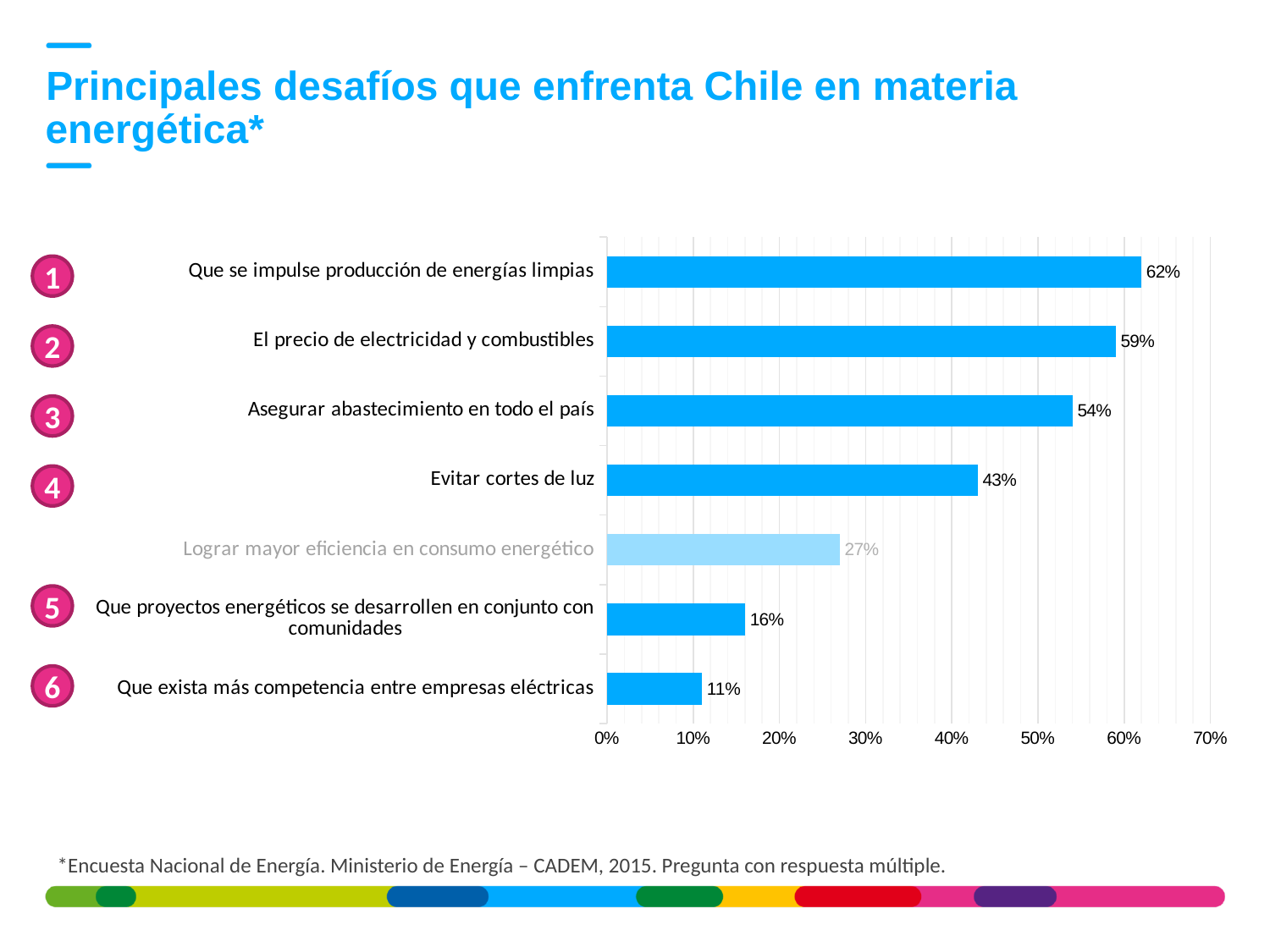
Which category has the highest value? Que se impulse producción de energías limpias What is the difference between "El precio de electricidad y combustibles" and "Asegurar abastecimiento en todo el país"? 5% How many categories are shown in the chart? 7 What is the value for "Que se impulse producción de energías limpias"? 62% Which category has the lowest value? Que exista más competencia entre empresas eléctricas Is the value for "Que proyectos energéticos se desarrollen en conjunto con comunidades" greater or less than 20%? less What kind of chart is shown on the slide? bar chart What is the title of the slide? Principales desafíos que enfrenta Chile en materia energética* Which is larger: "Evitar cortes de luz" or "Lograr mayor eficiencia en consumo energético"? Evitar cortes de luz What is the value for "Lograr mayor eficiencia en consumo energético"? 27% What is the value for "Que exista más competencia entre empresas eléctricas"? 11% What is the value for "Evitar cortes de luz"? 43%